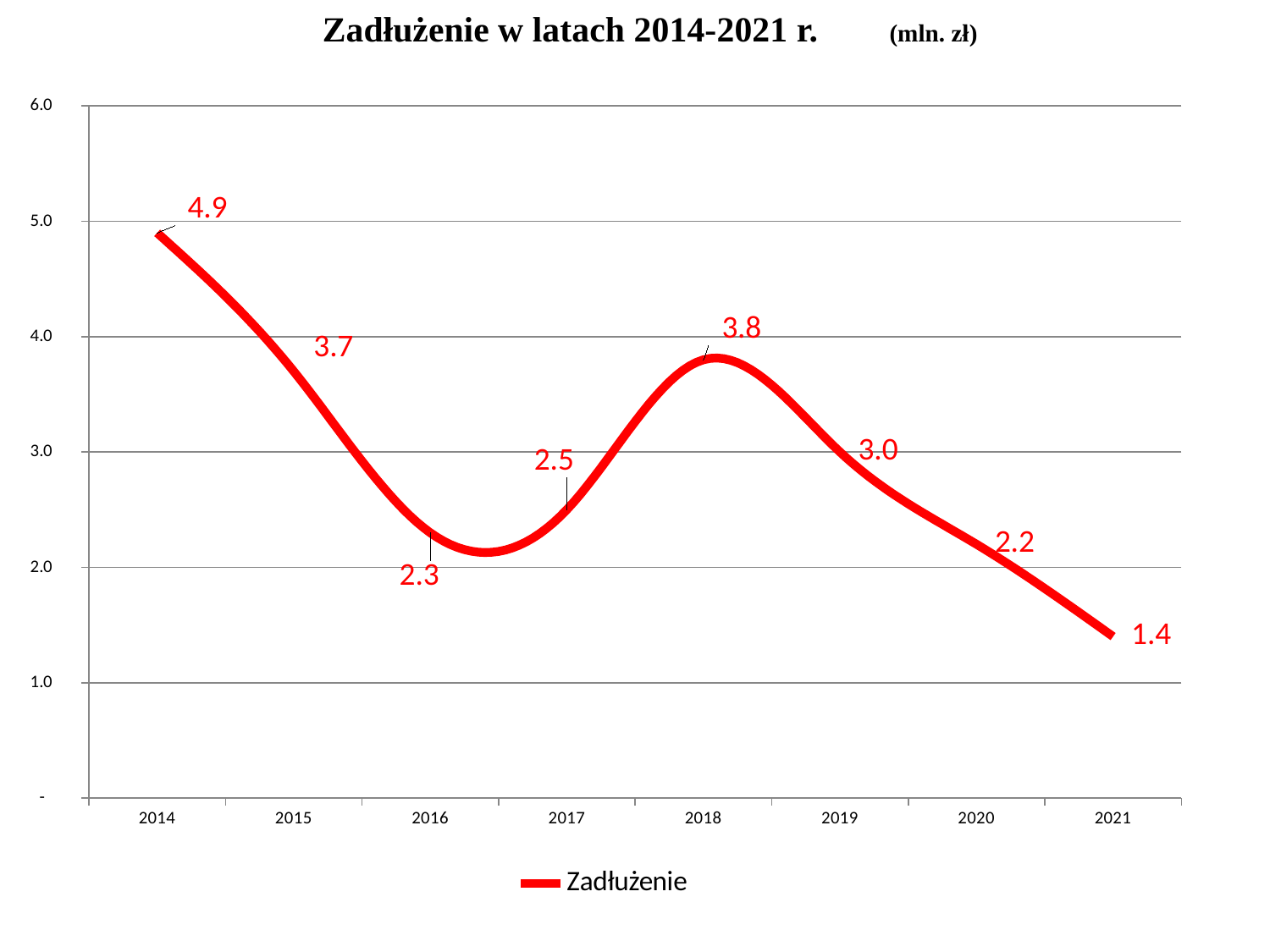
Which year has the highest value? 2014 How many series does the legend list? 1 What is the difference between the values for 2014 and 2021? 3.5 What is the value for 2021? 1.4 What kind of chart is shown? line chart How many years are plotted on the chart? 8 What is the value for 2014? 4.9 What is the value for 2018? 3.8 Which year has the lowest value? 2021 Do the values rise or fall from 2018 to 2021? fall Which is larger, the value for 2016 or the value for 2017? 2017 What is the difference between the values for 2018 and 2019? 0.8